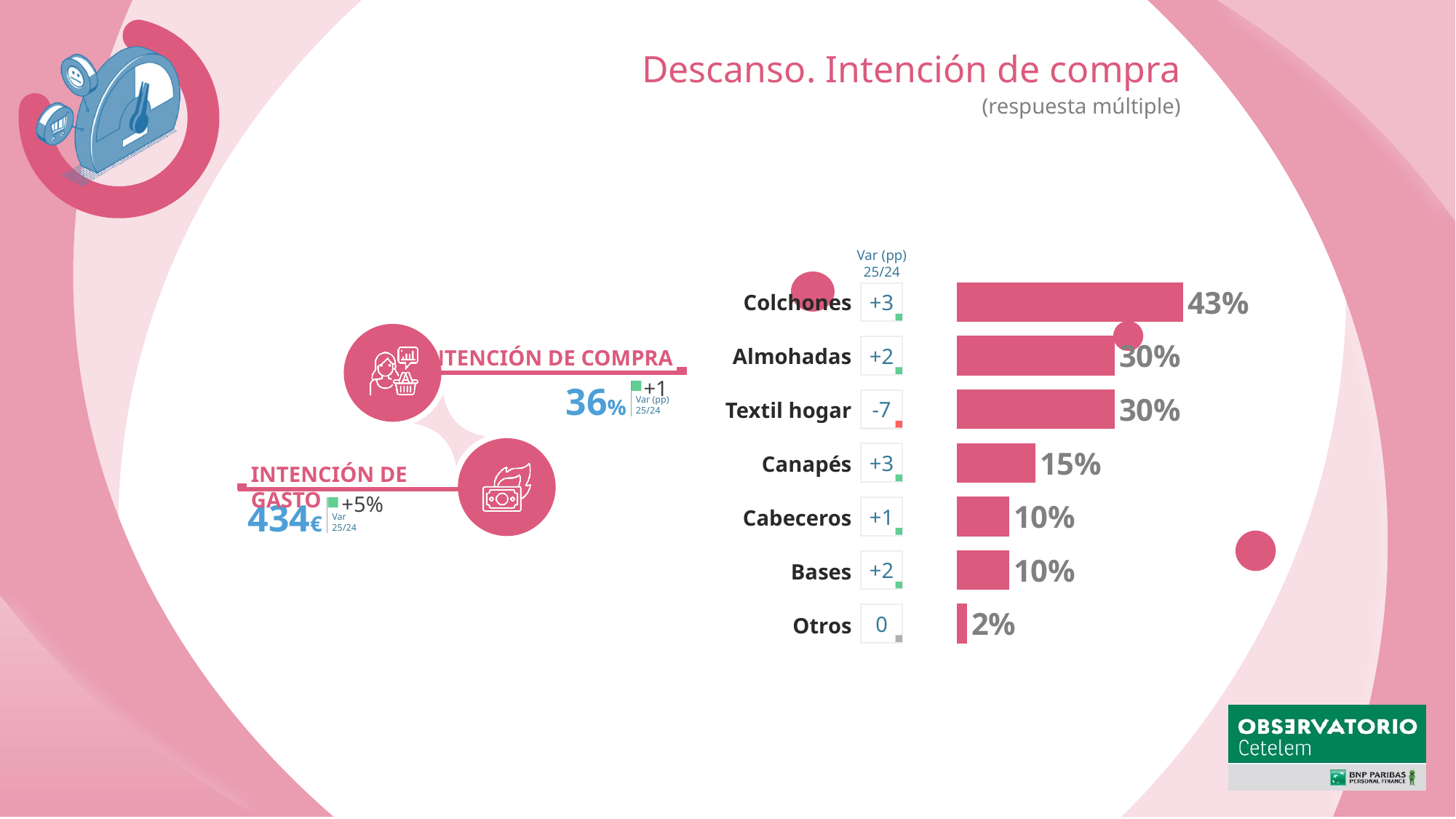
What is the Var (pp) 25/24 value shown for Colchones? +3 Which is larger, the value for Canapés or the value for Cabeceros? Canapés What kind of chart is shown on the slide? Bar chart What is the difference between the values for Colchones and Almohadas? 13% Which category has the lowest value in the bar chart? Otros What is the title of the slide containing the bar chart? Descanso. Intención de compra What is the value for Colchones in the bar chart? 43% How many categories are shown in the bar chart? 7 What is the Var (pp) 25/24 value shown for Textil hogar? -7 What is the value for Otros in the bar chart? 2% Which category has the highest value in the bar chart? Colchones What is the value for Canapés in the bar chart? 15%